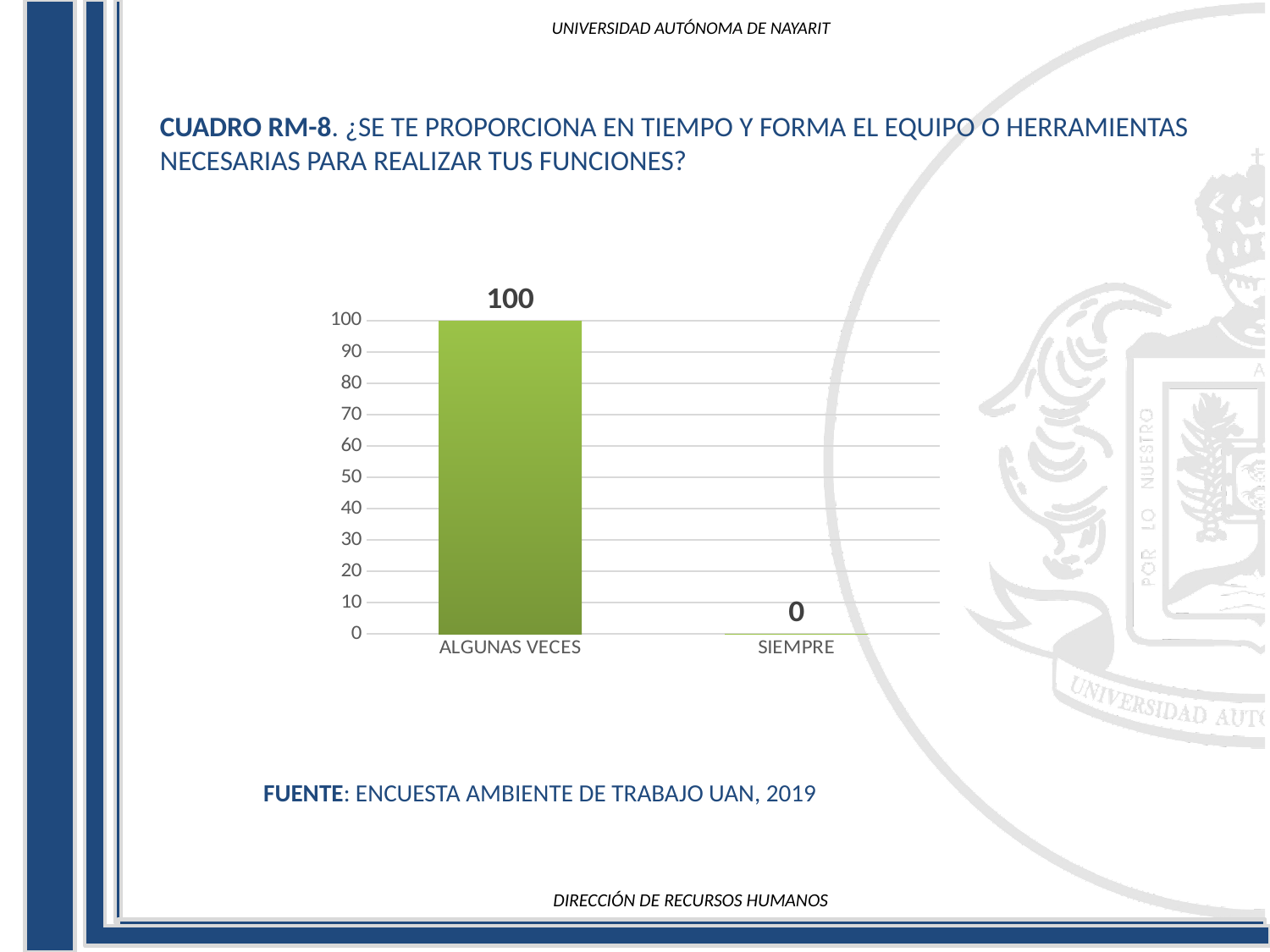
What source is cited below the chart? ENCUESTA AMBIENTE DE TRABAJO UAN, 2019 Do the values rise or fall from ALGUNAS VECES to SIEMPRE? fall Which is larger, the value for ALGUNAS VECES or the value for SIEMPRE? ALGUNAS VECES What is the highest tick value shown on the vertical axis? 100 Which category has the highest value? ALGUNAS VECES What is the difference between the values for ALGUNAS VECES and SIEMPRE? 100 Which category has the lowest value? SIEMPRE Is the value for ALGUNAS VECES greater or less than 50? greater What is the value for ALGUNAS VECES? 100 What kind of chart is shown on the slide? bar chart How many categories are shown on the x axis? 2 What is the value for SIEMPRE? 0